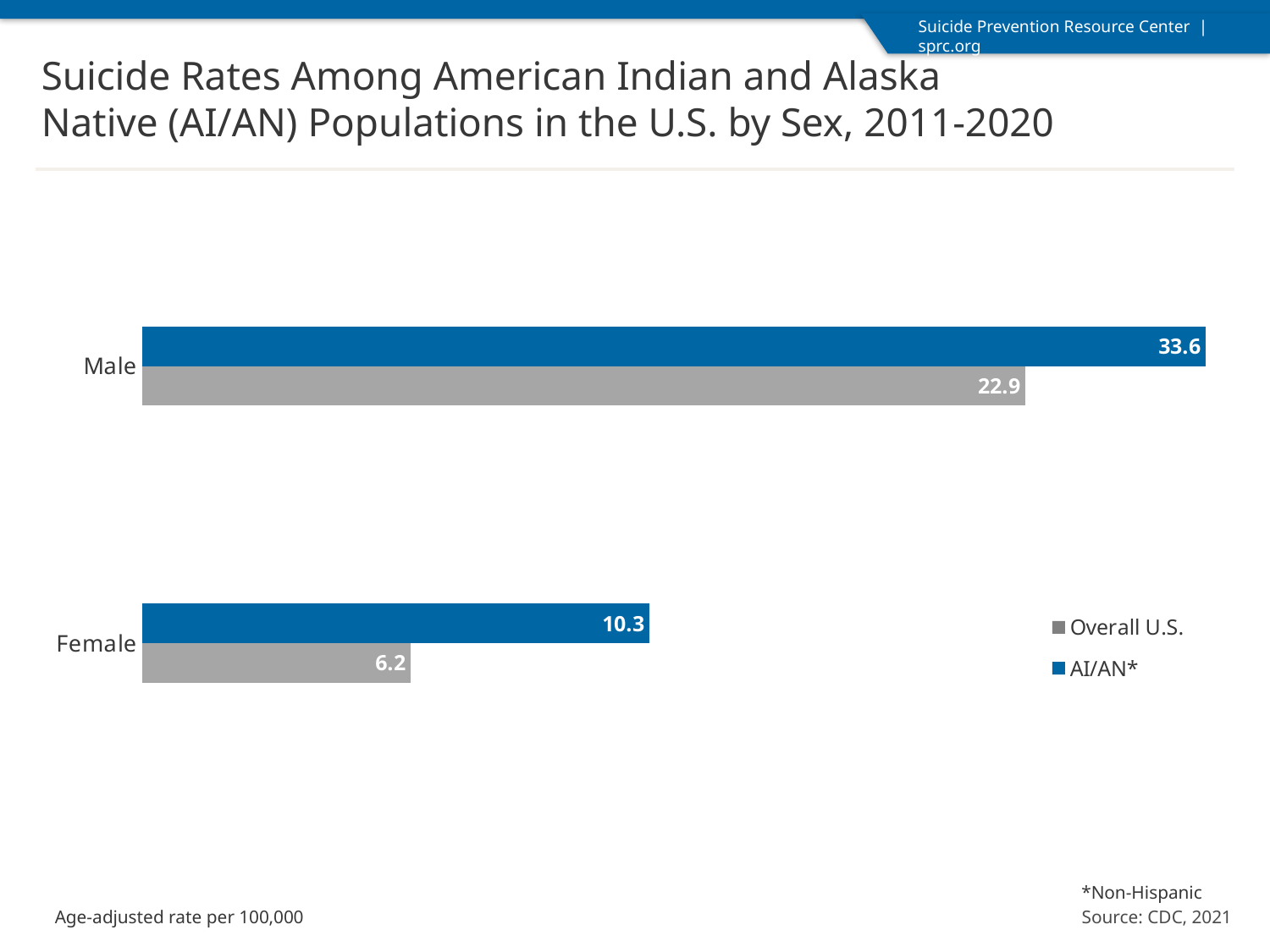
What is the difference between the AI/AN* and Overall U.S. rates for males? 10.7 What is the Overall U.S. suicide rate for males? 22.9 Which bar shows the lowest value on the chart? Female, Overall U.S. What is the AI/AN* suicide rate for males? 33.6 What kind of chart is shown on the slide? Bar chart How many categories are shown on the chart? 2 Which is larger for females, the AI/AN* rate or the Overall U.S. rate? AI/AN* How many series does the legend list? 2 What is the AI/AN* suicide rate for females? 10.3 What is the Overall U.S. suicide rate for females? 6.2 Which bar shows the highest value on the chart? Male, AI/AN* What is the difference between the AI/AN* and Overall U.S. rates for females? 4.1